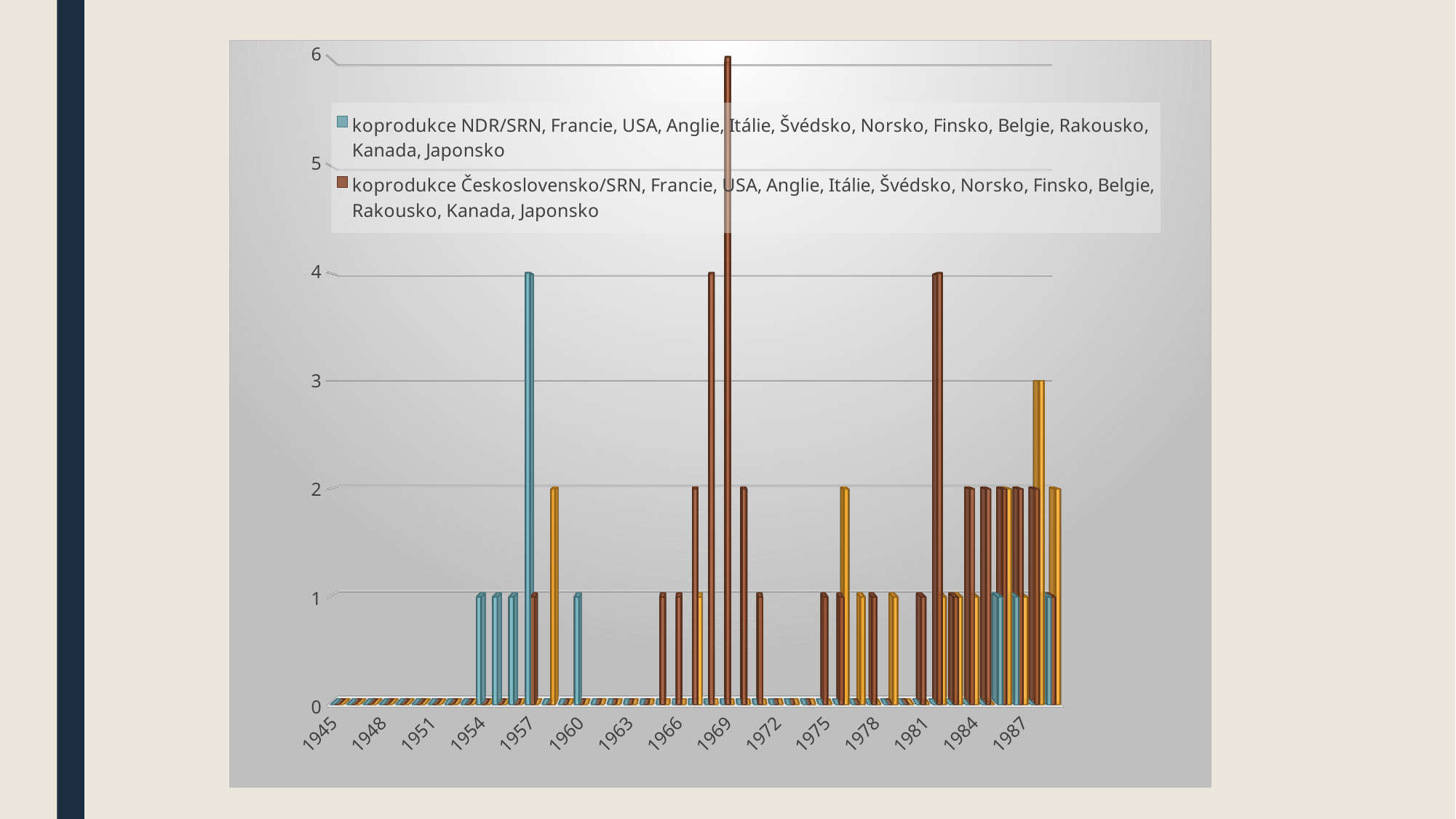
What is the difference between the tallest brown bar (6) and the tallest teal bar (4)? 2 What colour is the series 'koprodukce NDR/SRN, Francie, USA, Anglie, Itálie, Švédsko, Norsko, Finsko, Belgie, Rakousko, Kanada, Japonsko' in the legend? teal (blue) Which is taller: the tallest brown bar or the tallest teal bar? the tallest brown bar What value does the tallest gold bar reach? 3 How many year labels are shown on the x axis? 15 Is the tallest teal bar greater or less than 5? less Is the tallest brown bar greater or less than 5? greater How many series does the legend list? 2 What value does the tallest teal (blue) bar reach? 4 What is the highest value reached by any bar in the chart? 6 What kind of chart is shown on the slide? bar chart What is the maximum value shown on the vertical axis? 6